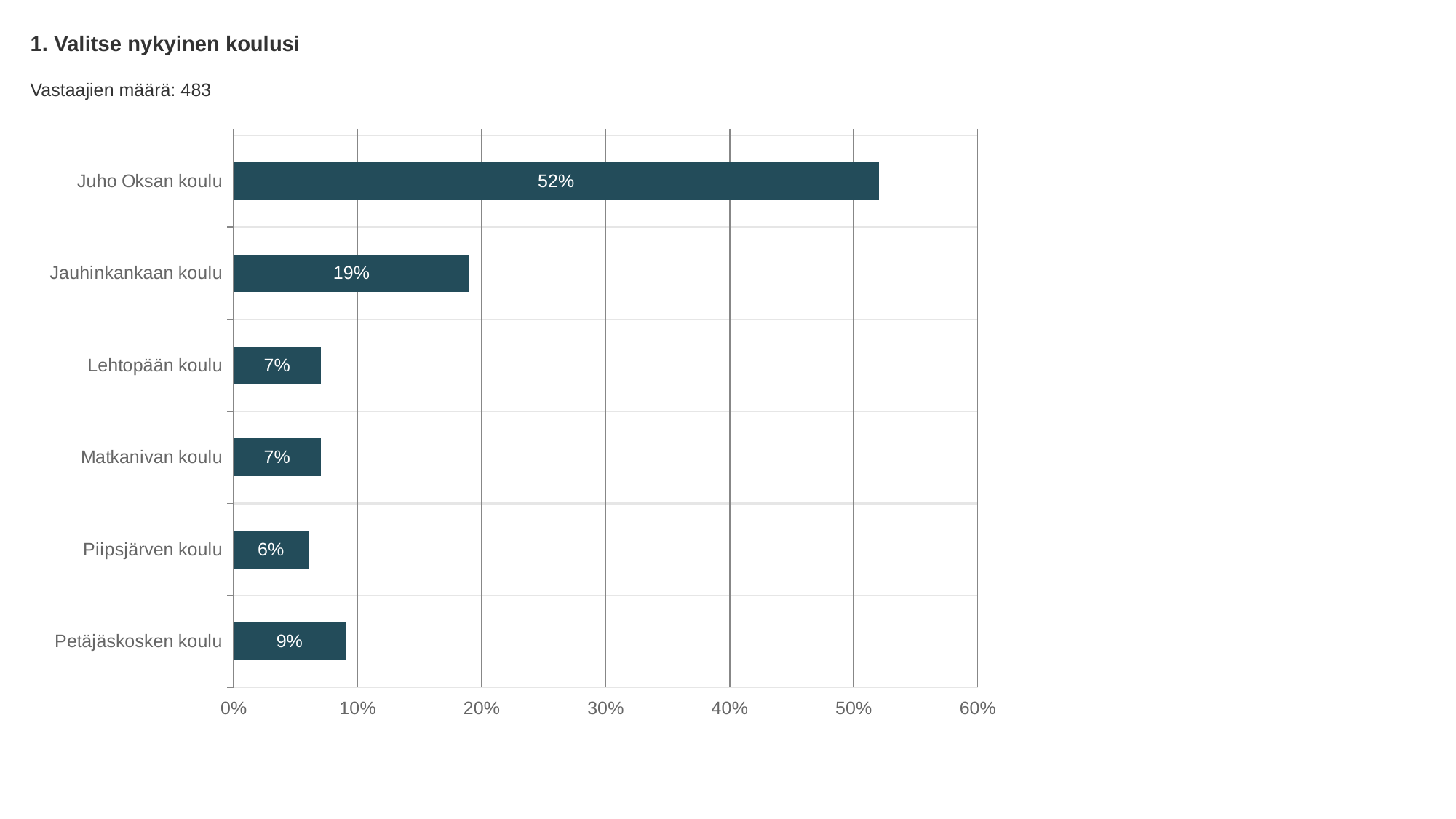
What is the title of the chart? 1. Valitse nykyinen koulusi What is the value for Petäjäskosken koulu? 9% What is the value for Juho Oksan koulu? 52% What is the difference between the values for Juho Oksan koulu and Jauhinkankaan koulu? 33% Is the value for Jauhinkankaan koulu greater or less than 20%? less Which is larger, the value for Petäjäskosken koulu or Lehtopään koulu? Petäjäskosken koulu What kind of chart is shown on the slide? bar chart How many schools are shown in the chart? 6 What is the value for Piipsjärven koulu? 6% What is the value for Jauhinkankaan koulu? 19% Which school has the lowest value? Piipsjärven koulu Which school has the highest value? Juho Oksan koulu